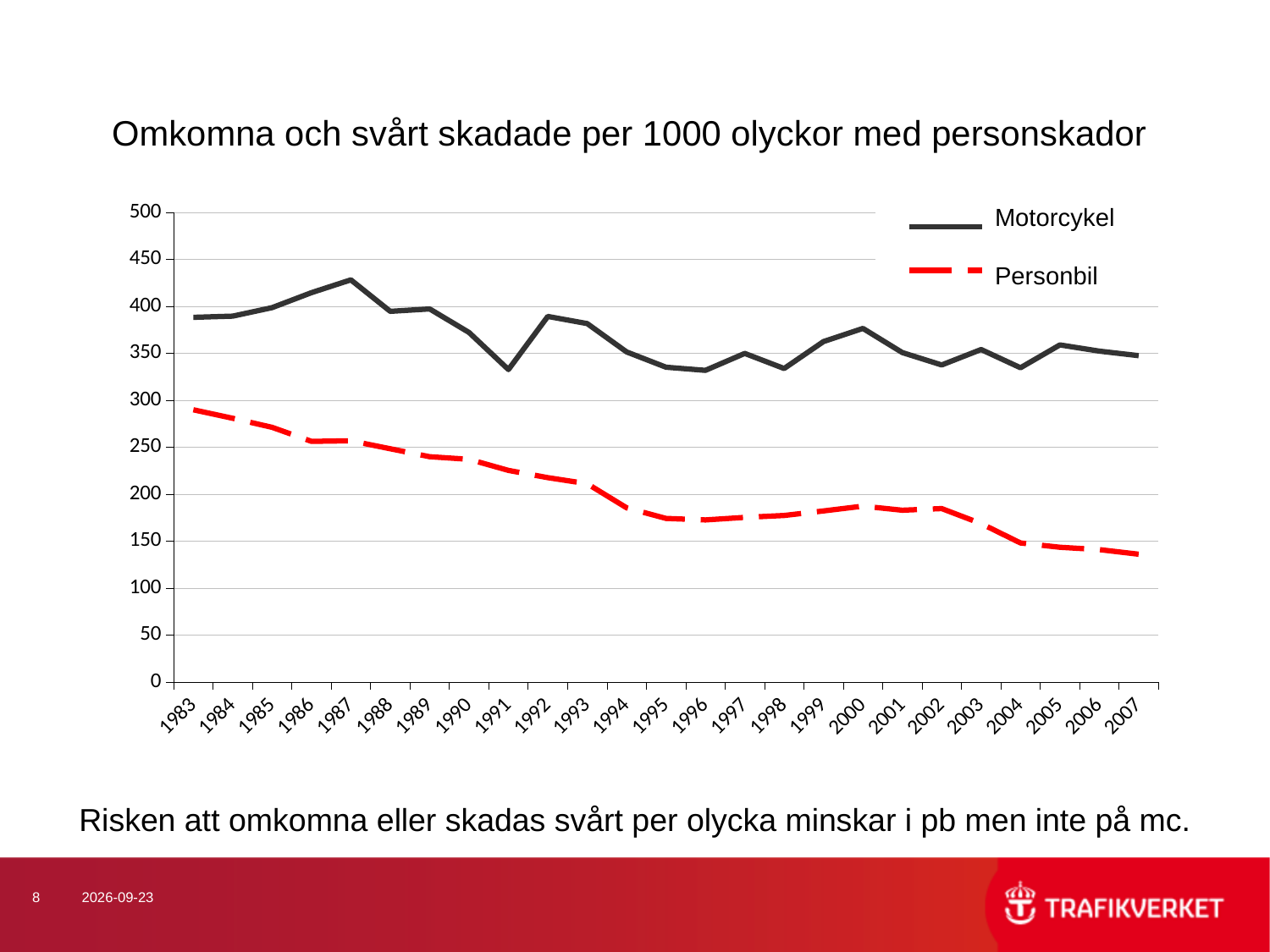
How many years are plotted along the x axis? 25 What is the title of the chart? Omkomna och svårt skadade per 1000 olyckor med personskador What kind of chart is shown on the slide? line chart Is the value for Personbil in 2007 greater or less than 150? less Is the value for Motorcykel in 1991 greater or less than 350? less Which series is drawn as a red dashed line? Personbil In 2000, which series has the higher value, Motorcykel or Personbil? Motorcykel Is the value for Personbil in 1983 greater or less than 250? greater Does the Personbil series generally rise or fall from 1983 to 2007? fall How many series does the legend list? 2 In which year does the Motorcykel series reach its highest value? 1987